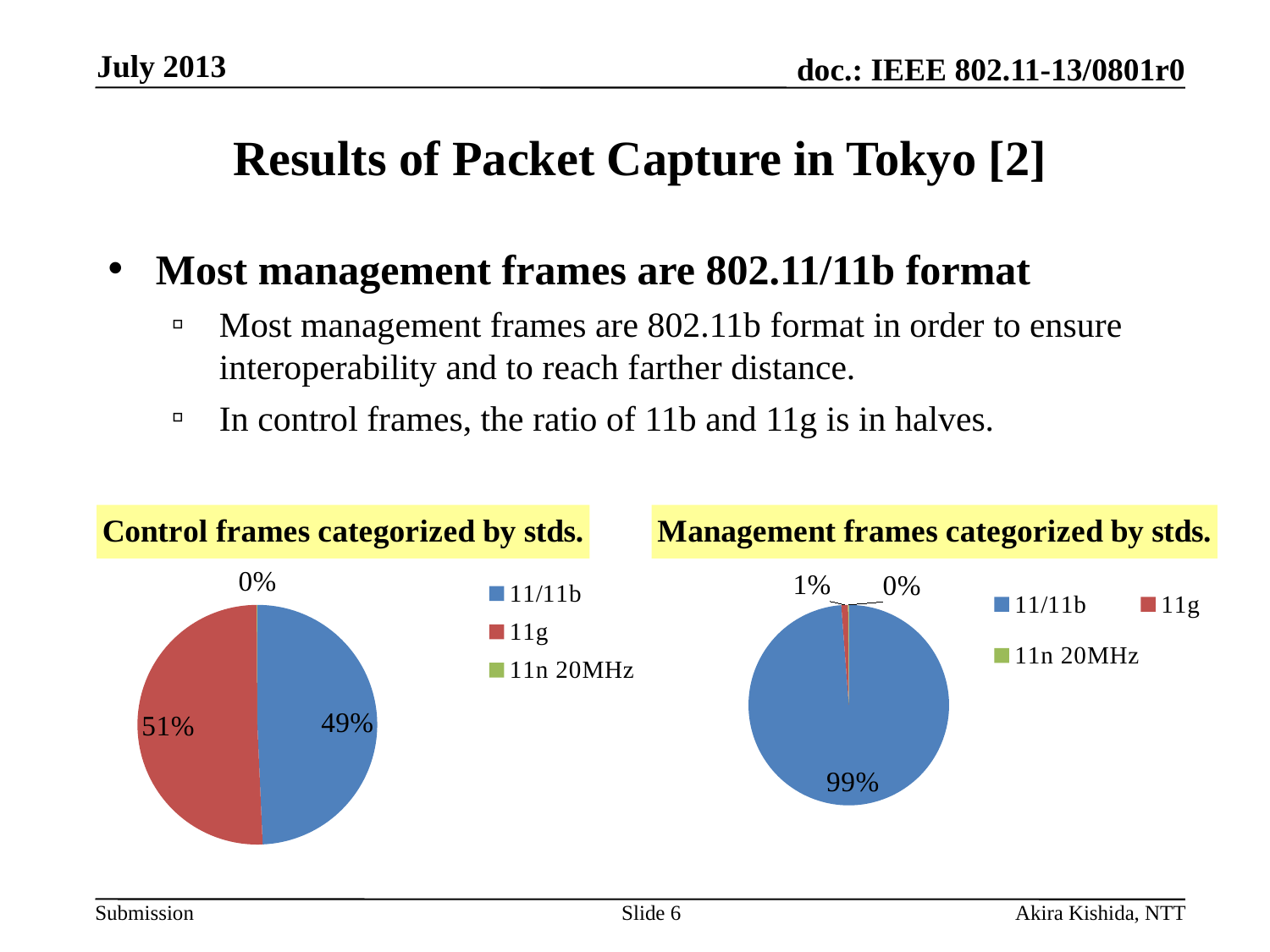
In the 'Control frames categorized by stds.' chart, which category has the largest share? 11g What type of chart is the 'Control frames categorized by stds.' chart? Pie chart In the 'Management frames categorized by stds.' chart, what share is labelled for 11g? 1% In the 'Control frames categorized by stds.' chart, which category has the smallest share? 11n 20MHz In the 'Control frames categorized by stds.' chart, what is the difference between the 11g share and the 11/11b share? 2% In the 'Management frames categorized by stds.' chart, what share is labelled for 11n 20MHz? 0% How many entries does the legend of the 'Management frames categorized by stds.' chart list? 3 In the 'Control frames categorized by stds.' chart, what share is labelled for 11/11b? 49% In the 'Management frames categorized by stds.' chart, what share is labelled for 11/11b? 99% In the 'Control frames categorized by stds.' chart, what share is labelled for 11g? 51% In the 'Management frames categorized by stds.' chart, which category has the largest share? 11/11b In the 'Management frames categorized by stds.' chart, what is the difference between the 11/11b share and the 11g share? 98%